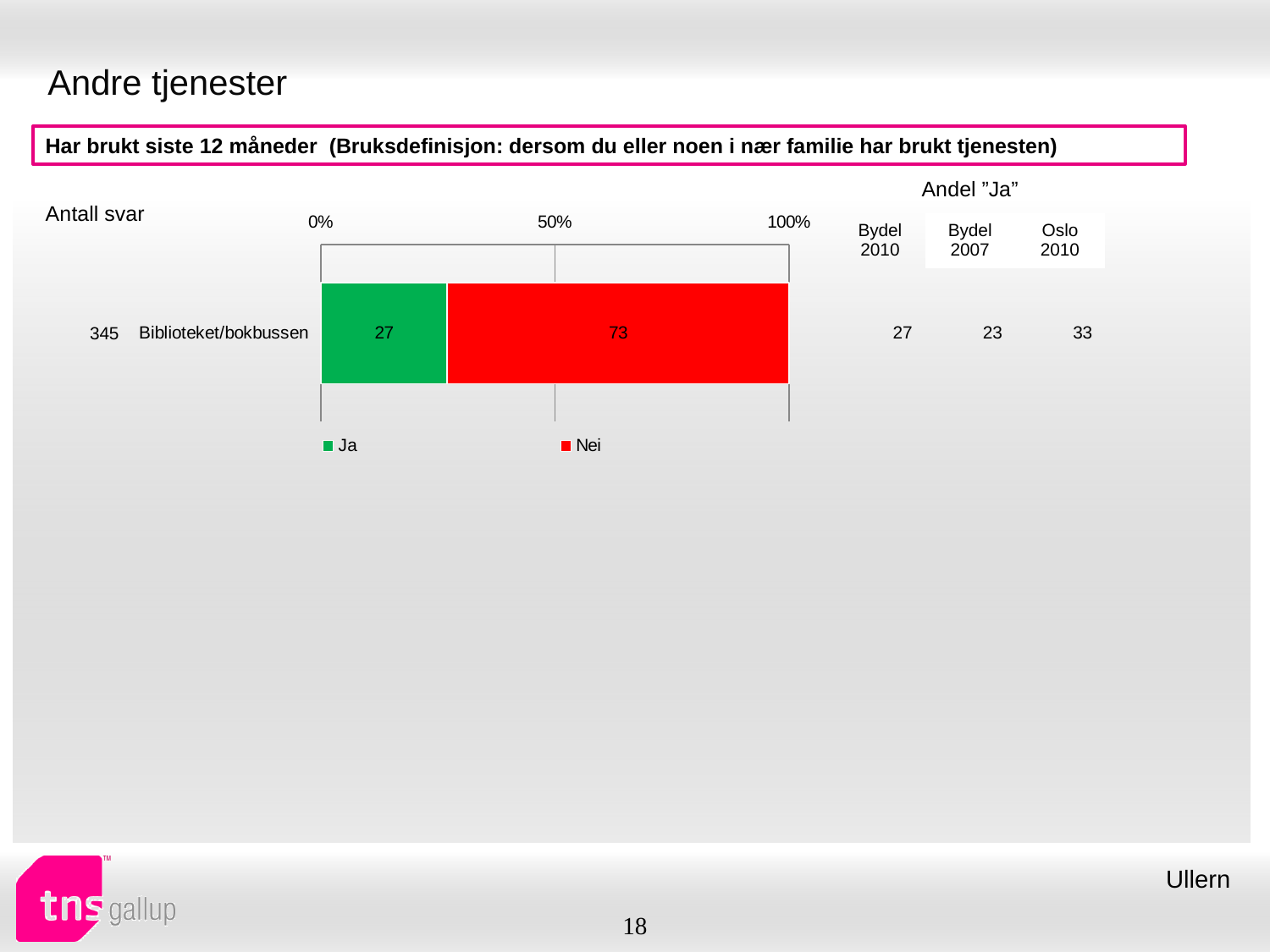
What is the total of the stacked bar for Biblioteket/bokbussen? 100 What is the value for "Ja" for Biblioteket/bokbussen? 27 Which series has the larger value for Biblioteket/bokbussen, Ja or Nei? Nei Is the value for Ja for Biblioteket/bokbussen greater or less than 50%? less What is the number of responses (Antall svar) shown for Biblioteket/bokbussen? 345 What kind of chart is shown on the slide? Stacked bar chart How many categories are plotted in the chart? 1 What colour represents the "Ja" series in the chart? Green What is the difference between the Nei and Ja values for Biblioteket/bokbussen? 46 What is the value for "Nei" for Biblioteket/bokbussen? 73 Is the value for Nei for Biblioteket/bokbussen greater or less than 50%? greater How many series does the legend list? 2